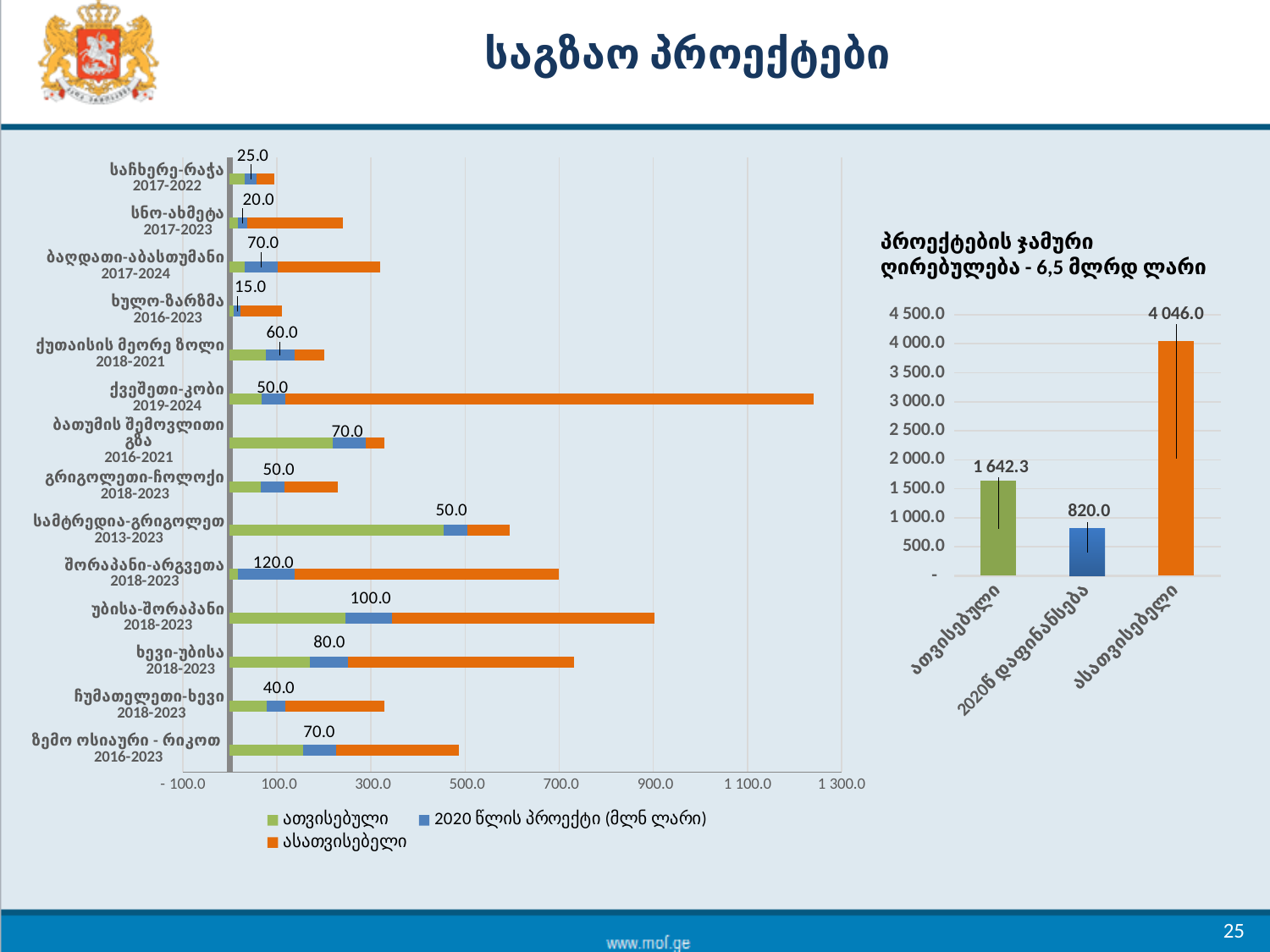
On the left chart, is the total stacked bar for ქვეშეთი-კობი 2019-2024 greater or less than 1 100.0? greater On the left chart, which project has the highest labelled 2020 project value? შორაპანი-არგვეთა 2018-2023 How many projects (categories) are shown on the left chart? 14 On the left chart, what is the labelled 2020 project value for შორაპანი-არგვეთა 2018-2023? 120.0 On the right chart, what is the difference between ასათვისებელი and ათვისებული? 2 403.7 What kind of chart is the left chart? Stacked bar chart On the left chart, which project has the lowest labelled 2020 project value? ხულო-ზარზმა 2016-2023 On the right chart, what is the value for ასათვისებელი? 4 046.0 On the left chart, what is the difference between the labelled 2020 values for უბისა-შორაპანი 2018-2023 and ჩუმათელეთი-ხევი 2018-2023? 60.0 On the left chart, what is the labelled 2020 project value for ხულო-ზარზმა 2016-2023? 15.0 How many series does the legend of the left chart list? 3 On the right chart, which category has the lowest value? 2020წ დაფინანსება